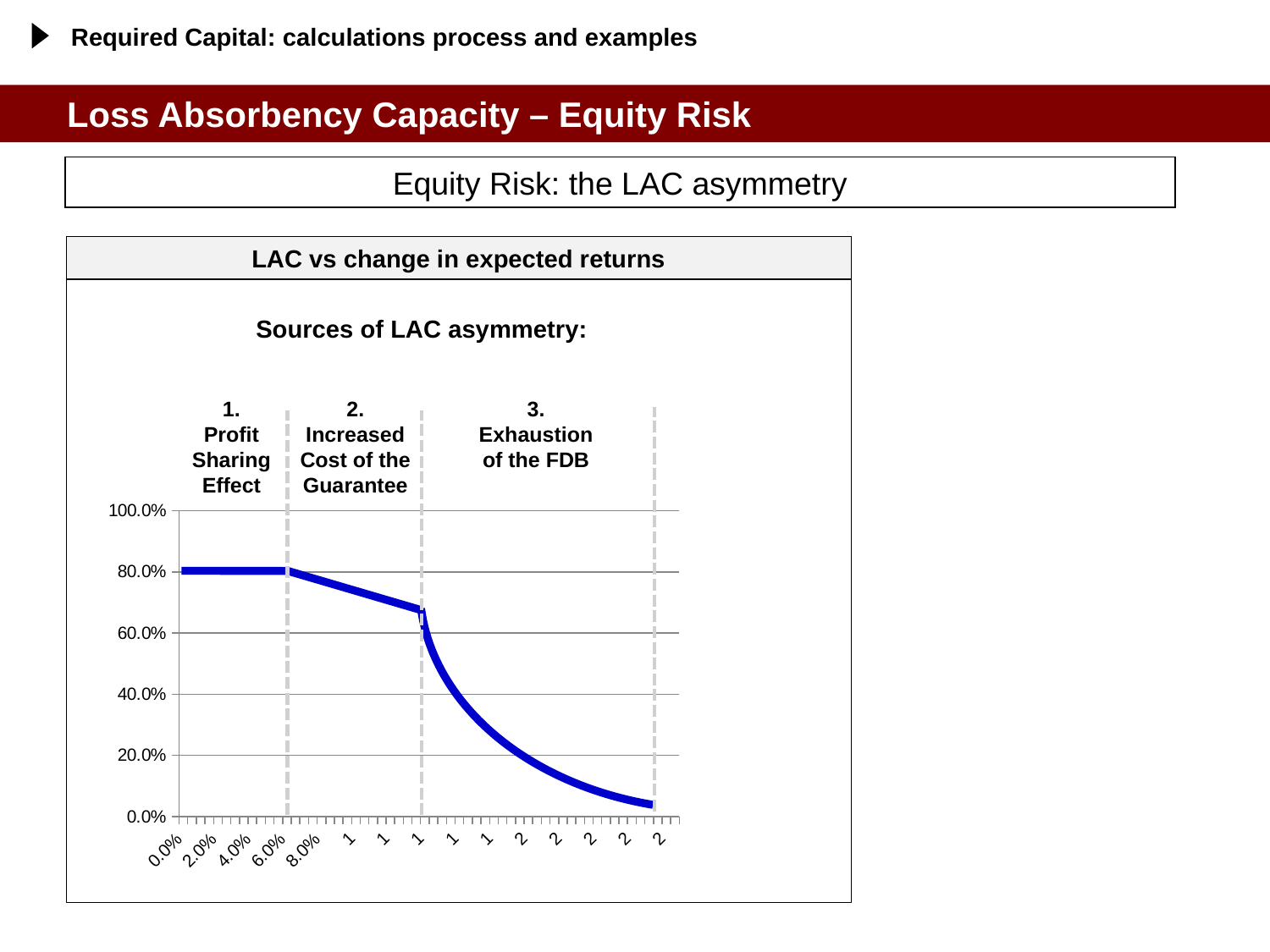
What is the title of the chart? LAC vs change in expected returns Is the value at 0.0% on the x axis greater or less than 100.0%? less Is the value at 8.0% on the x axis greater or less than 40.0%? greater Is the value at 2.0% on the x axis greater or less than 100.0%? less What kind of chart is shown on the slide? line chart How many sources of LAC asymmetry are labelled above the chart? 3 Do the values in the chart rise or fall as you move along the x axis from left to right? fall